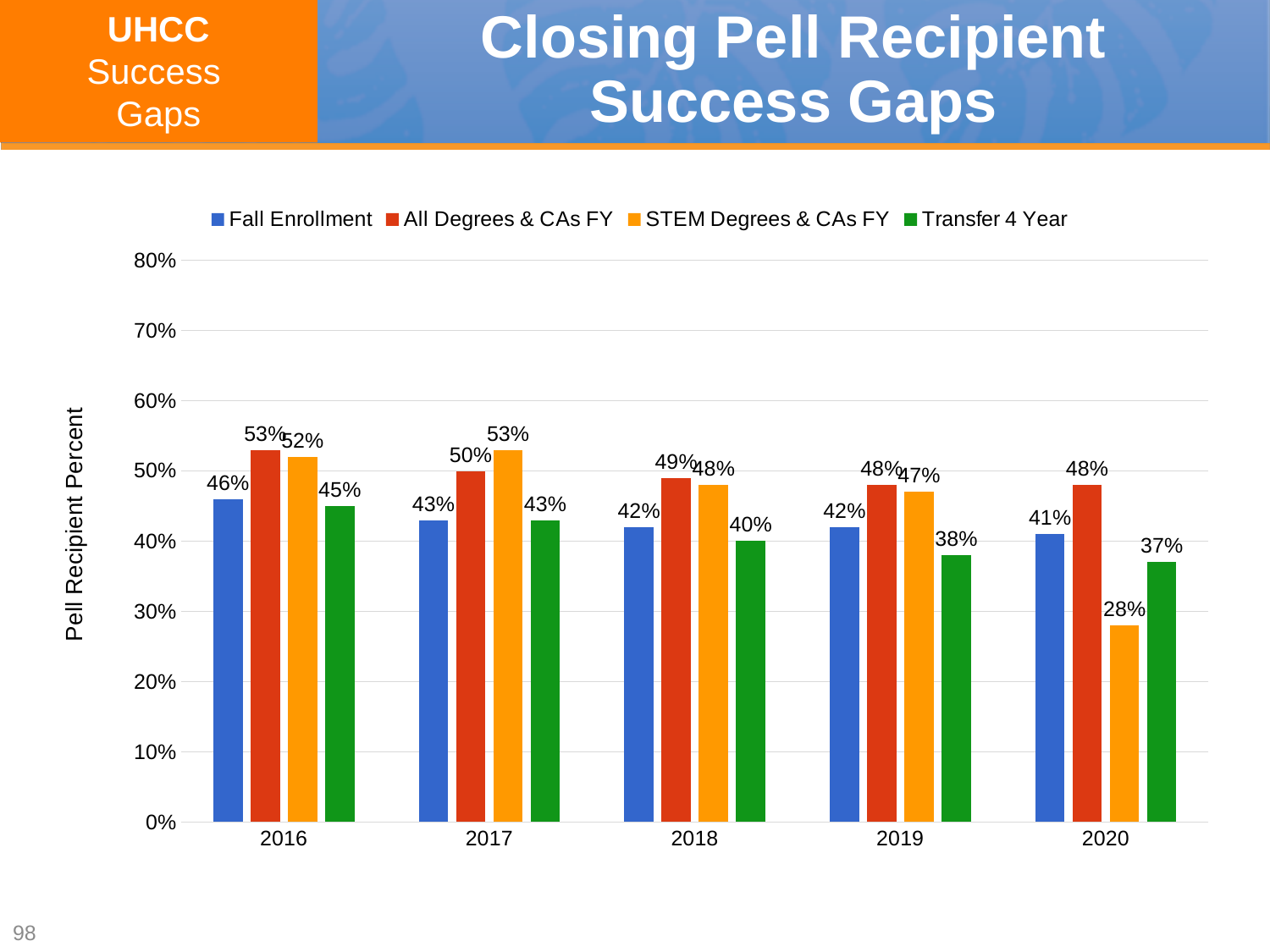
What is the Transfer 4 Year value for 2019? 38% In which year is the Transfer 4 Year value lowest? 2020 What is the Fall Enrollment value for 2016? 46% What kind of chart is shown on the slide? Bar chart What is the All Degrees & CAs FY value for 2017? 50% In which year is the Fall Enrollment value highest? 2016 Does the Fall Enrollment value rise or fall from 2016 to 2020? Fall How many years are shown on the x axis? 5 Which is larger in 2017: the STEM Degrees & CAs FY value or the All Degrees & CAs FY value? STEM Degrees & CAs FY What is the STEM Degrees & CAs FY value for 2020? 28% What is the difference between the All Degrees & CAs FY value and the STEM Degrees & CAs FY value in 2020? 20% How many series does the legend list? 4